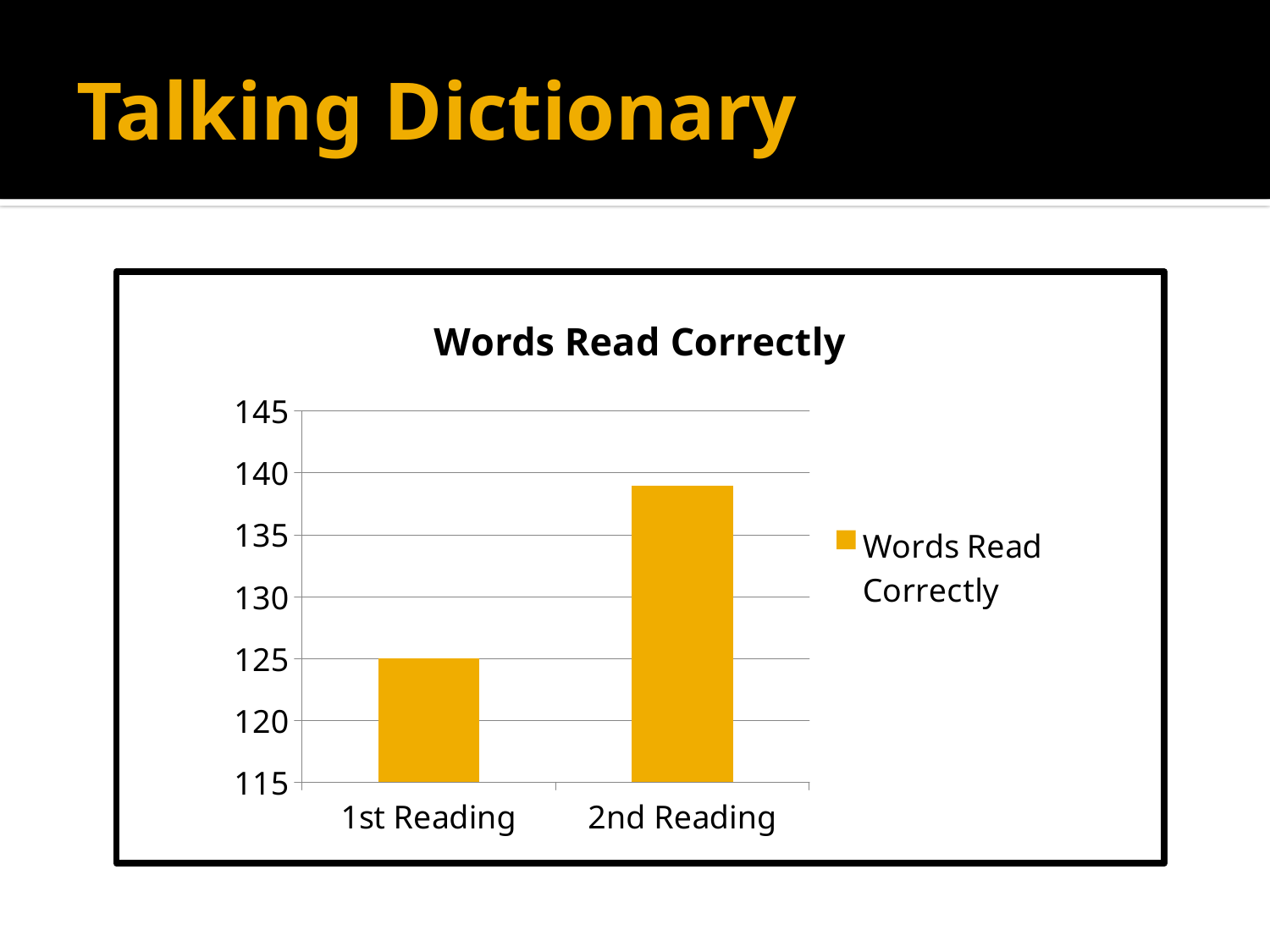
What kind of chart is shown on the slide? bar chart How many series does the legend list? 1 What is the title of the chart? Words Read Correctly Do the values rise or fall from 1st Reading to 2nd Reading? rise Is the value for 2nd Reading greater or less than 140? less Is the value for 2nd Reading greater or less than 135? greater What is the value for 1st Reading? 125 Which category has the lowest value? 1st Reading Which category has the highest value? 2nd Reading How many categories are shown on the x axis of the chart? 2 Which is larger, the value for 1st Reading or the value for 2nd Reading? 2nd Reading What series name appears in the legend? Words Read Correctly